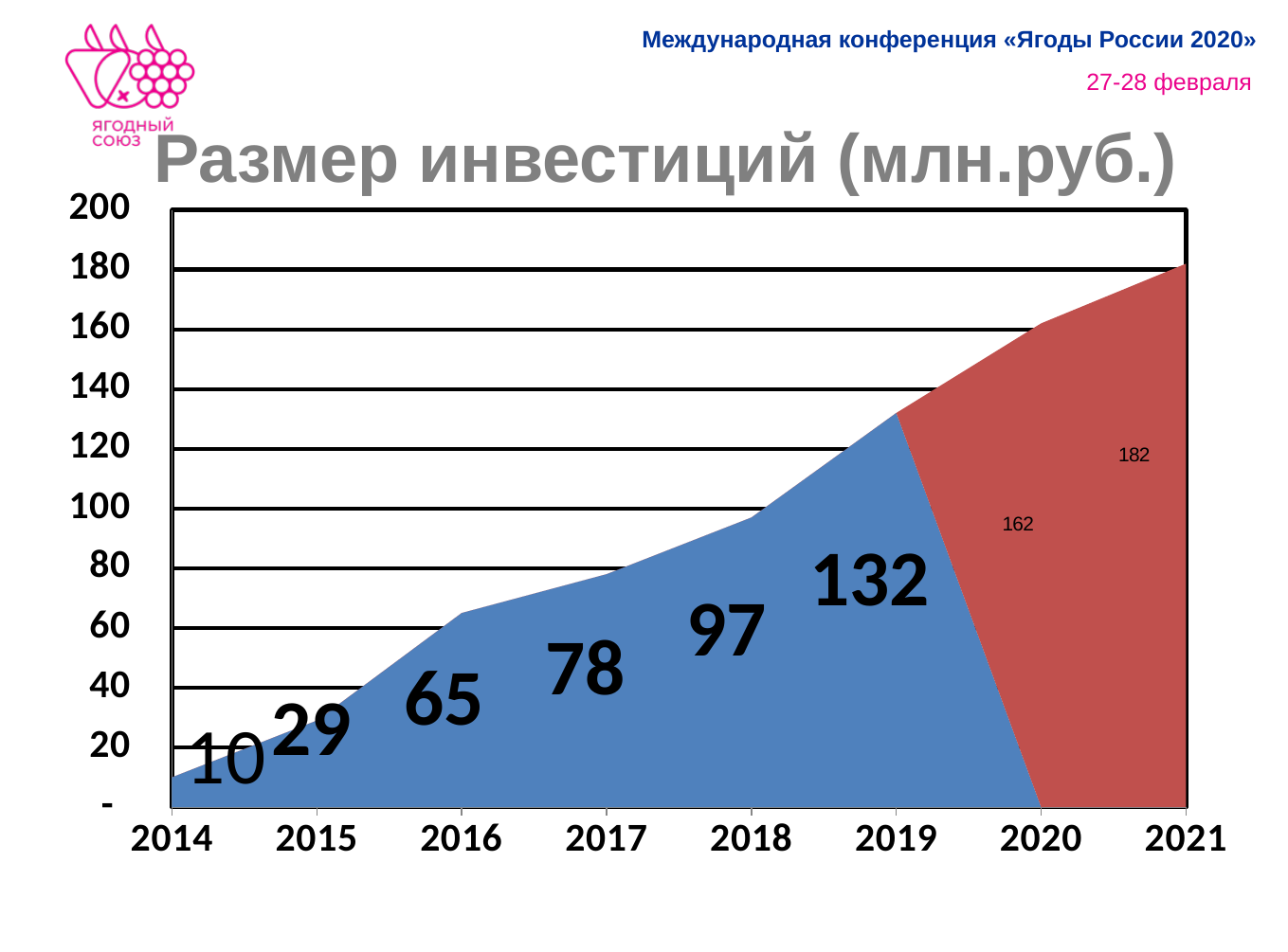
What is the value for 2019? 132 What is the difference between the values for 2020 and 2019? 30 How many years are shown on the x axis? 8 What is the value for 2017? 78 Which is larger, the value for 2016 or the value for 2018? 2018 Which year has the lowest value? 2014 Do the values rise or fall from 2014 to 2021? rise Which year has the highest value? 2021 What is the value for 2014? 10 What kind of chart is this? area chart What is the value for 2021? 182 What is the title of the chart? Размер инвестиций (млн.руб.)